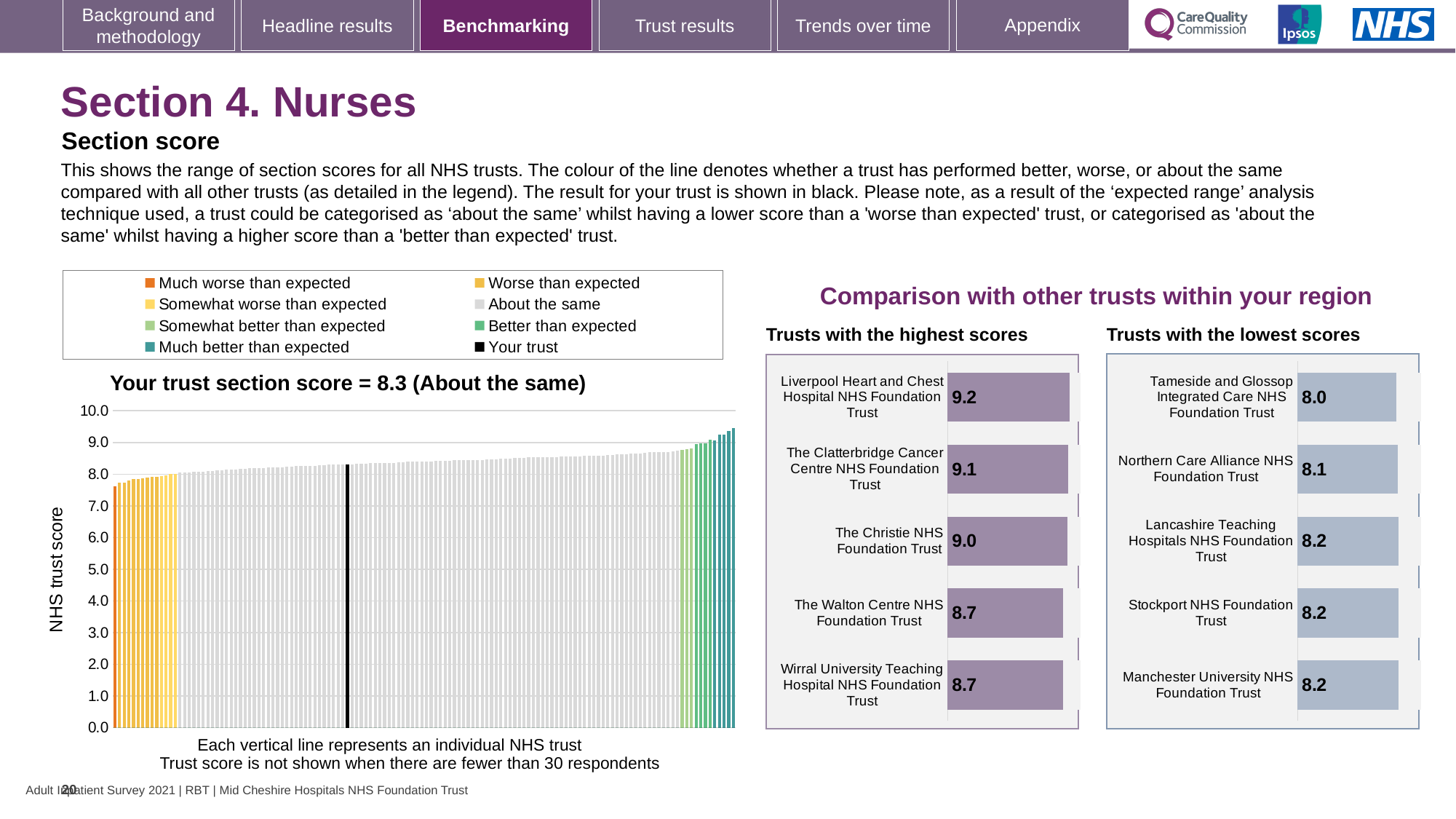
In the 'Trusts with the highest scores' chart, which trust has the highest score? Liverpool Heart and Chest Hospital NHS Foundation Trust In the 'Trusts with the highest scores' chart, what is the score for Liverpool Heart and Chest Hospital NHS Foundation Trust? 9.2 In the 'Trusts with the highest scores' chart, which has the higher score: The Clatterbridge Cancer Centre NHS Foundation Trust or The Christie NHS Foundation Trust? The Clatterbridge Cancer Centre NHS Foundation Trust In the 'Trusts with the lowest scores' chart, which trust has the lowest score? Tameside and Glossop Integrated Care NHS Foundation Trust In the main chart showing all NHS trusts, what is your trust's section score? 8.3 In the 'Trusts with the lowest scores' chart, what is the score for Stockport NHS Foundation Trust? 8.2 In the 'Trusts with the lowest scores' chart, what is the score for Tameside and Glossop Integrated Care NHS Foundation Trust? 8.0 In the main chart showing all NHS trusts, do the scores rise or fall from left to right along the x axis? Rise How many trusts are shown in the 'Trusts with the lowest scores' chart? 5 What kind of chart is the main chart showing the range of section scores for all NHS trusts? Bar chart In the 'Trusts with the highest scores' chart, what is the difference between the scores of Liverpool Heart and Chest Hospital NHS Foundation Trust and The Walton Centre NHS Foundation Trust? 0.5 How many entries does the legend above the main chart list? 8